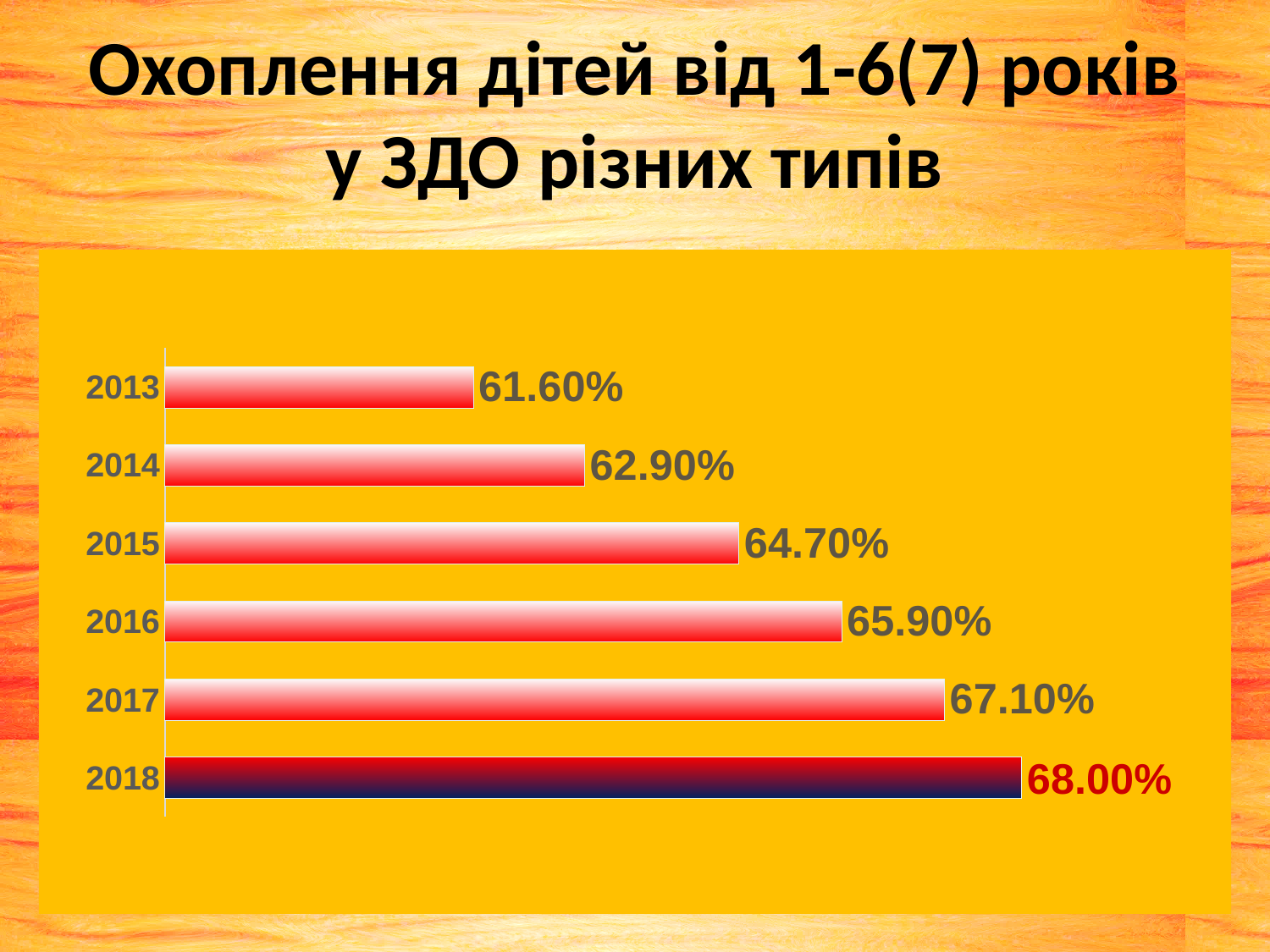
Which year has the lowest value? 2013 How many years are shown in the chart? 6 What is the difference between the values for 2018 and 2013? 6.40% Which is larger, the value for 2017 or the value for 2015? 2017 What is the value for 2018? 68.00% Which year has the highest value? 2018 What is the value for 2016? 65.90% What is the value for 2013? 61.60% What is the difference between the values for 2015 and 2014? 1.80% Which year's bar is drawn in a different, darker colour from the others? 2018 What kind of chart is shown on the slide? bar chart Do the values rise or fall from 2013 to 2018? rise